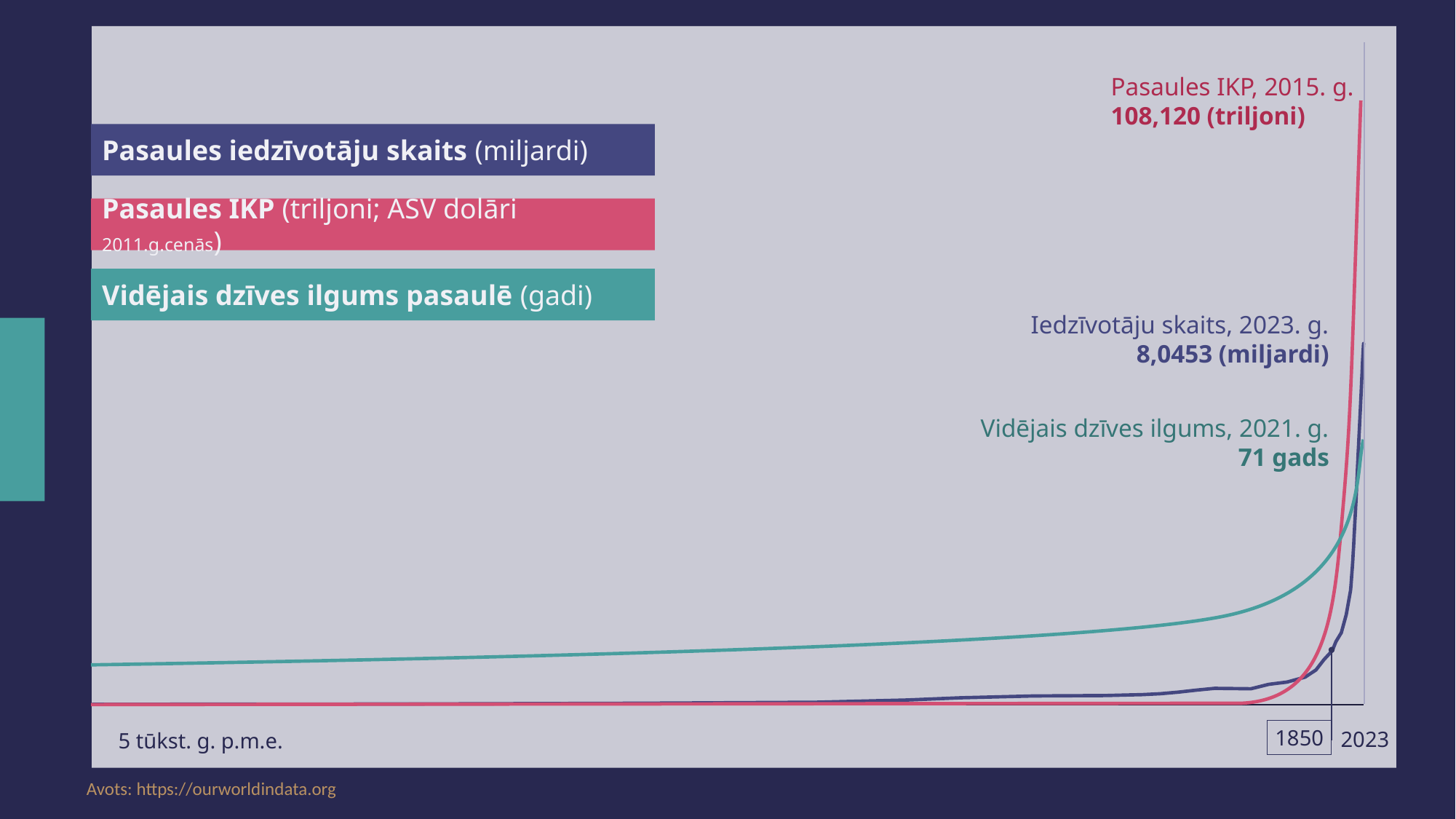
What is the value printed for Pasaules IKP in 2015? 108,120 (triljoni) Which year is marked with a box on the x axis just before 2023? 1850 What is the value printed for Vidējais dzīves ilgums in 2021? 71 gads In which year is the Iedzīvotāju skaits value of 8,0453 (miljardi) reported? 2023 Do the values of the Pasaules IKP line rise or fall as the x axis approaches 2023? Rise What kind of chart is shown on the slide? Line chart In which year is the Vidējais dzīves ilgums value of 71 gads reported? 2021 Do the values of the Vidējais dzīves ilgums line rise or fall along the x axis? Rise What is the label at the left end of the x axis? 5 tūkst. g. p.m.e. In which year is the Pasaules IKP value of 108,120 (triljoni) reported? 2015 What is the value printed for Iedzīvotāju skaits in 2023? 8,0453 (miljardi) How many series does the legend list? 3